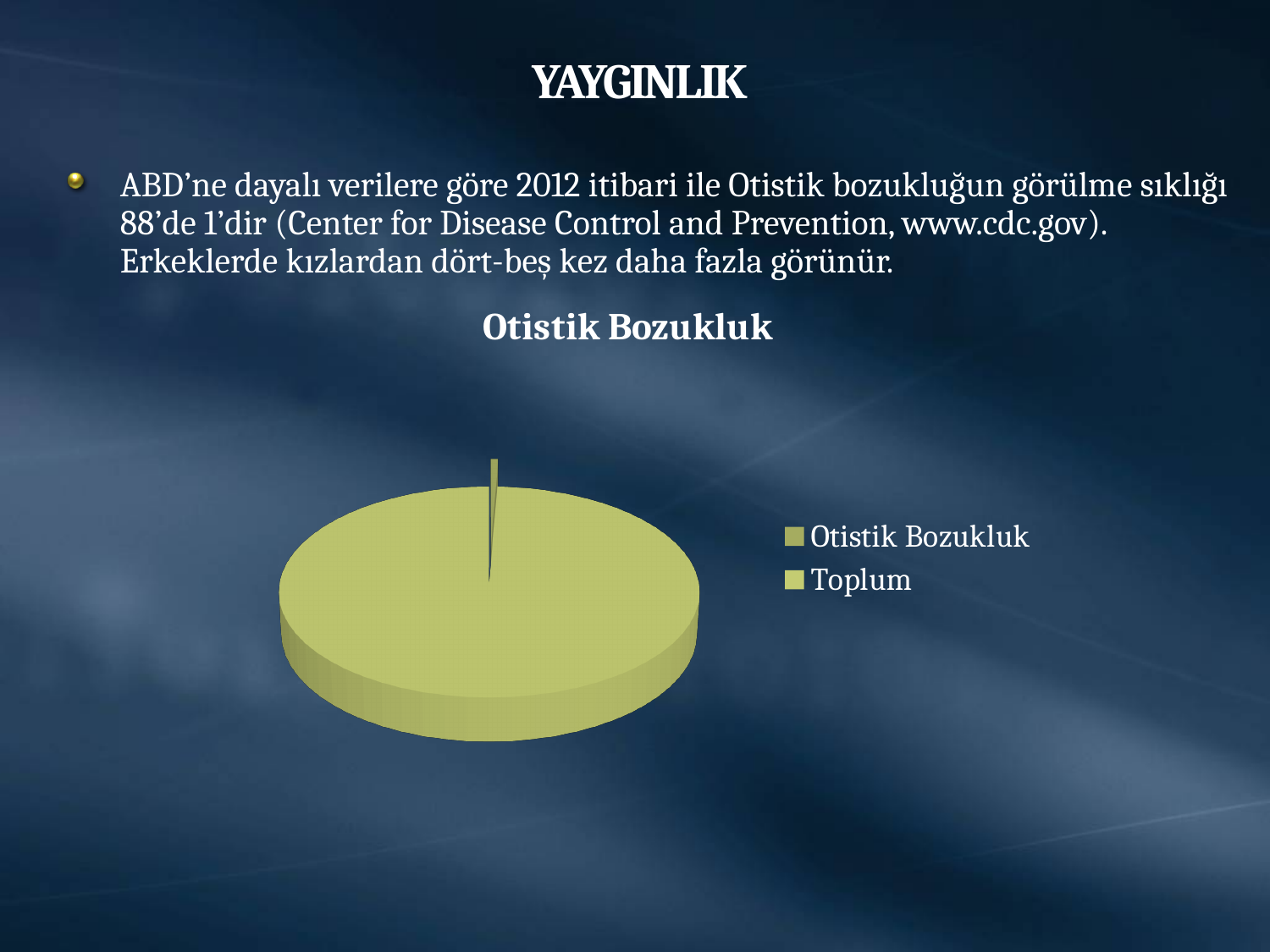
What is the title of the chart? Otistik Bozukluk Which slice is larger, Otistik Bozukluk or Toplum? Toplum How many entries does the chart's legend list? 2 Which category has the largest slice of the pie? Toplum What kind of chart is shown on the slide? pie chart Which category has the smallest slice of the pie? Otistik Bozukluk How many slices does the pie chart have? 2 What are the two categories listed in the chart's legend? Otistik Bozukluk and Toplum